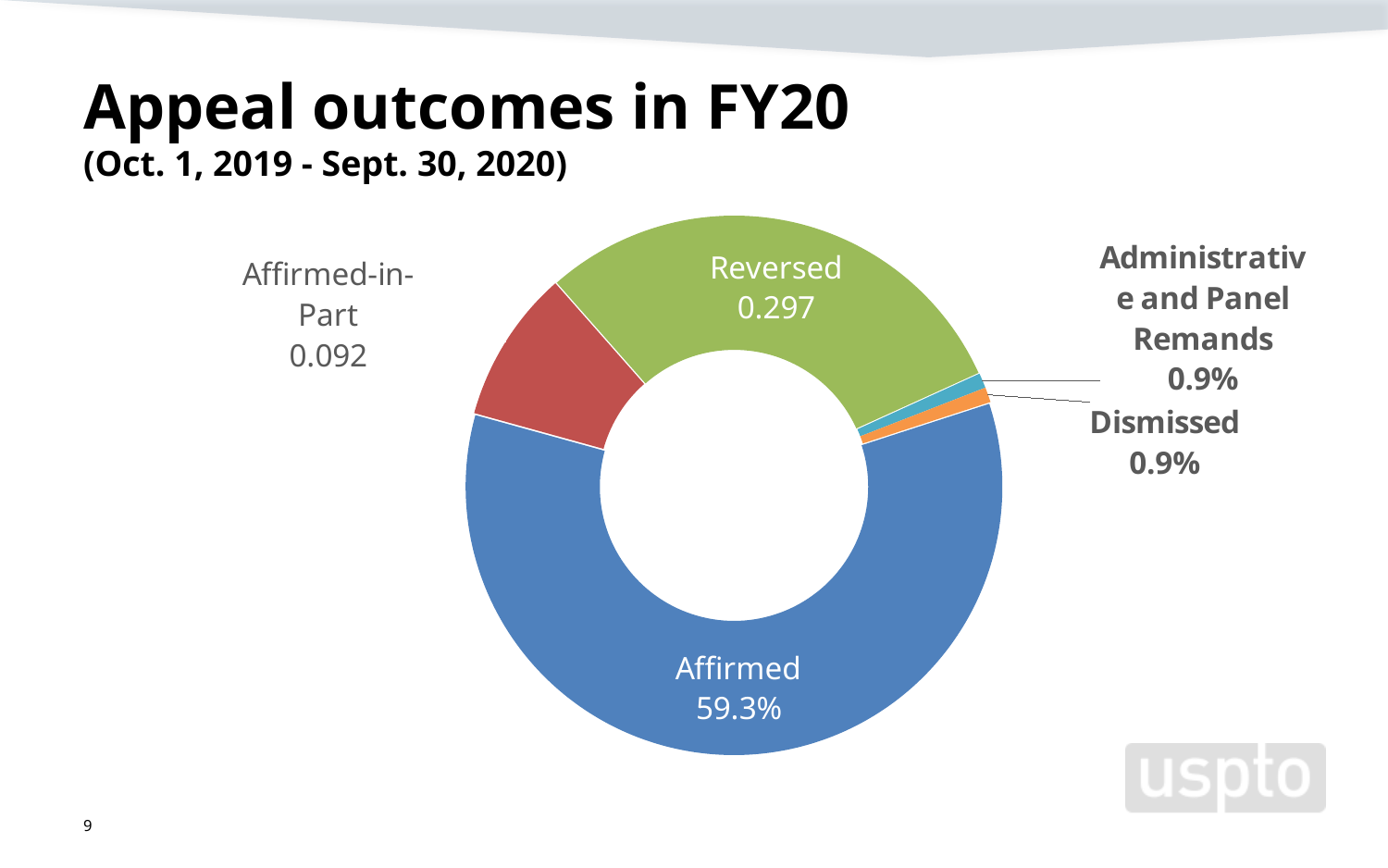
What share of appeal outcomes does the Affirmed slice represent? 59.3% What is the value shown for the Affirmed slice? 59.3% What kind of chart is shown on the slide? Doughnut (pie) chart Which appeal outcome has the largest slice of the chart? Affirmed How many outcome categories are shown in the chart? 5 Which is larger, the Reversed slice or the Affirmed-in-Part slice? Reversed What is the title of the slide containing the chart? Appeal outcomes in FY20 What value is printed for the Affirmed-in-Part slice? 0.092 What is the value shown for Administrative and Panel Remands? 0.9% What is the value shown for Dismissed? 0.9% What value is printed for the Reversed slice? 0.297 Which is larger, the Affirmed slice or the Reversed slice? Affirmed